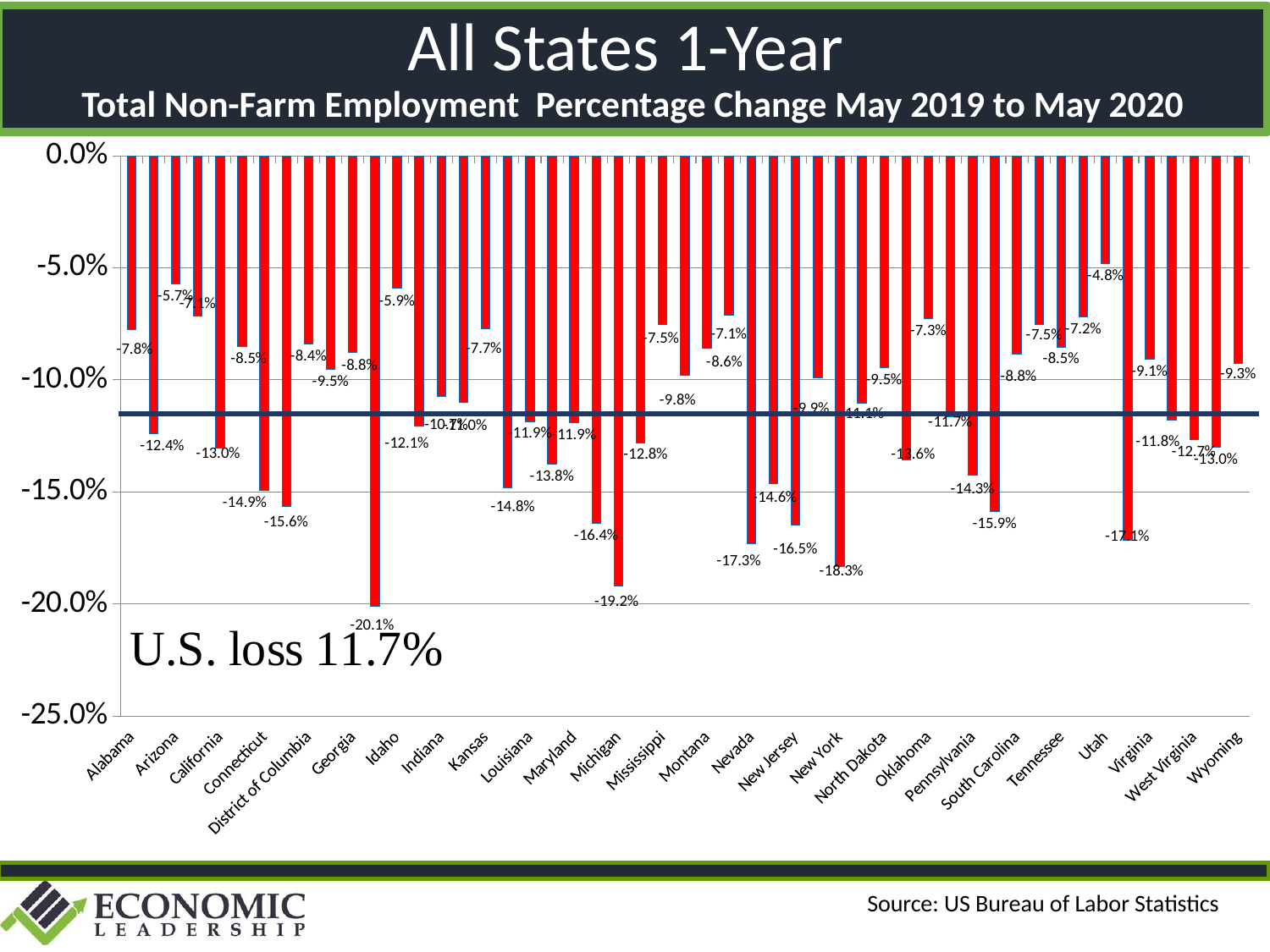
What is the percentage change shown for New York? -18.3% Is the value for Michigan greater or less than -15.0%? less What is the percentage change in total non-farm employment for Alabama? -7.8% Which labeled state has the smallest employment decline (the highest value) on the chart? Utah What is the percentage change shown for Utah? -4.8% What is the percentage change shown for Wyoming? -9.3% What type of chart is shown on the slide? bar chart What is the percentage change shown for Michigan? -19.2% What is the difference in percentage points between the values for Alabama (-7.8%) and Utah (-4.8%)? 3.0 percentage points What is the lowest value shown on the chart? -20.1% Which state shows a larger employment decline, Nevada or New York? New York What U.S. loss figure is annotated on the chart? 11.7%